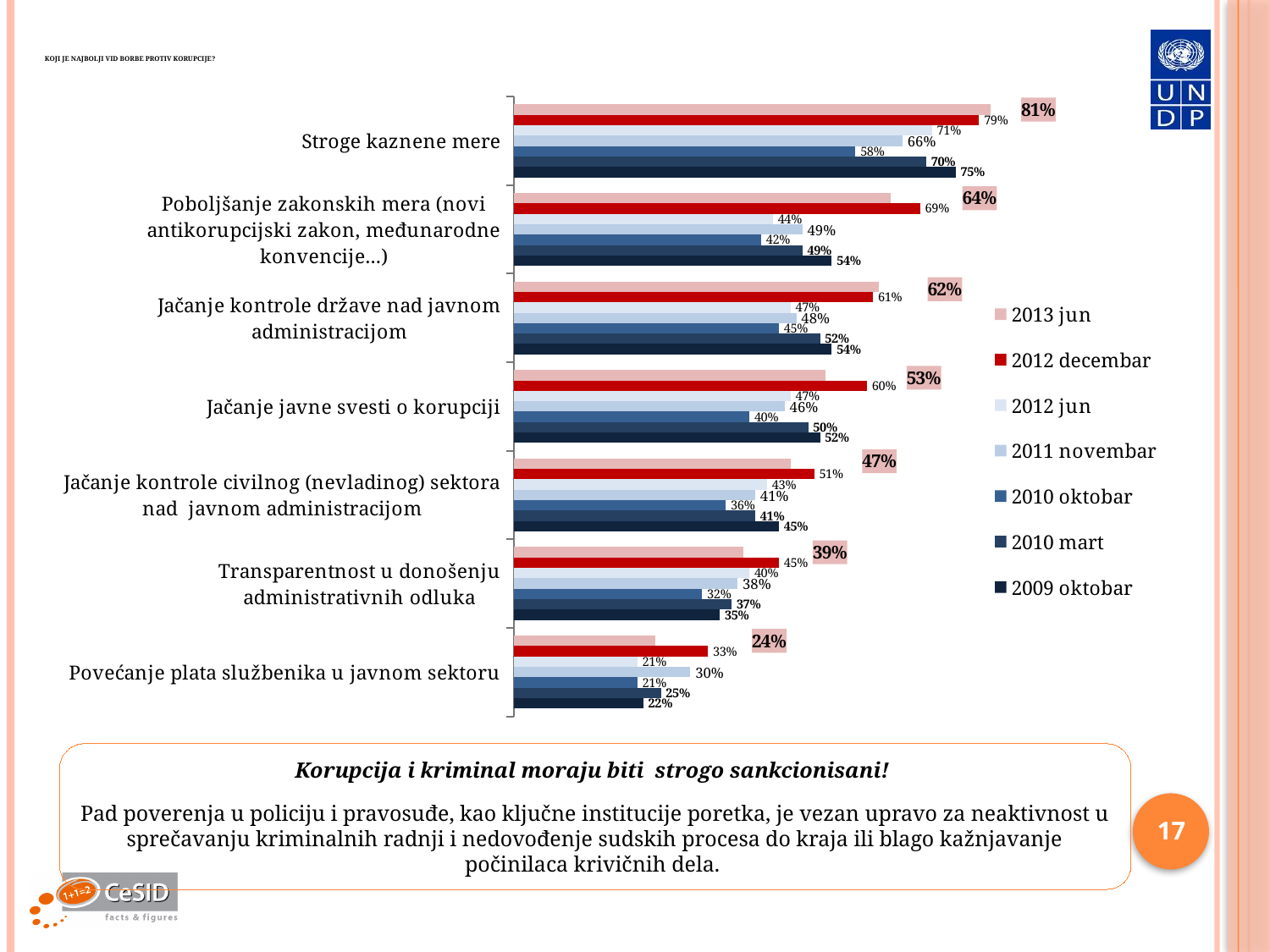
How many series does the legend list? 7 Which series is listed first in the legend? 2013 jun In the 2013 jun series, what is the difference between 'Stroge kaznene mere' and 'Povećanje plata službenika u javnom sektoru'? 57 percentage points What is the value for 'Stroge kaznene mere' in the 2013 jun series? 81% What kind of chart is shown on the slide? bar chart What is the value for 'Poboljšanje zakonskih mera (novi antikorupcijski zakon, međunarodne konvencije...)' in the 2012 decembar series? 69% What is the value for 'Transparentnost u donošenju administrativnih odluka' in the 2013 jun series? 39% For 'Jačanje javne svesti o korupciji', which is larger: the 2013 jun value or the 2012 decembar value? 2012 decembar How many categories (answer options) are plotted on the chart? 7 Which category has the lowest value in the 2013 jun series? Povećanje plata službenika u javnom sektoru Which category has the highest value in the 2013 jun series? Stroge kaznene mere What is the value for 'Povećanje plata službenika u javnom sektoru' in the 2012 decembar series? 33%